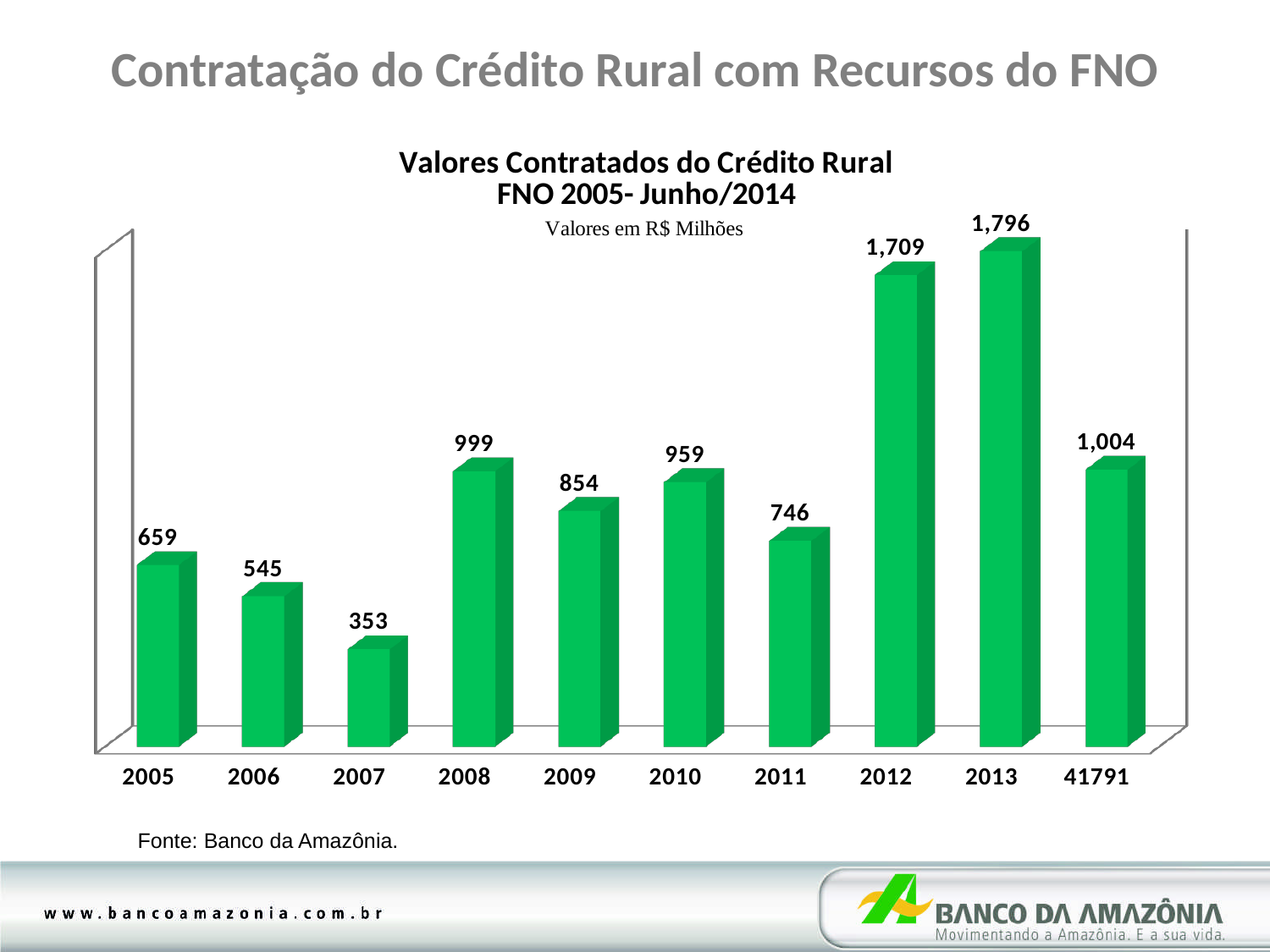
What is the value for 2012? 1,709 How many bars are shown in the chart? 10 What is the difference between the values for 2013 and 2012? 87 Which year has the highest value? 2013 What is the value for 2007? 353 Do the values rise or fall from 2005 to 2007? Fall What is the difference between the values for 2005 and 2006? 114 What kind of chart is shown on the slide? Bar chart Which year has the lowest value? 2007 What is the value for 2008? 999 What unit is stated below the chart title? Valores em R$ Milhões Which is larger, the value for 2009 or the value for 2010? 2010